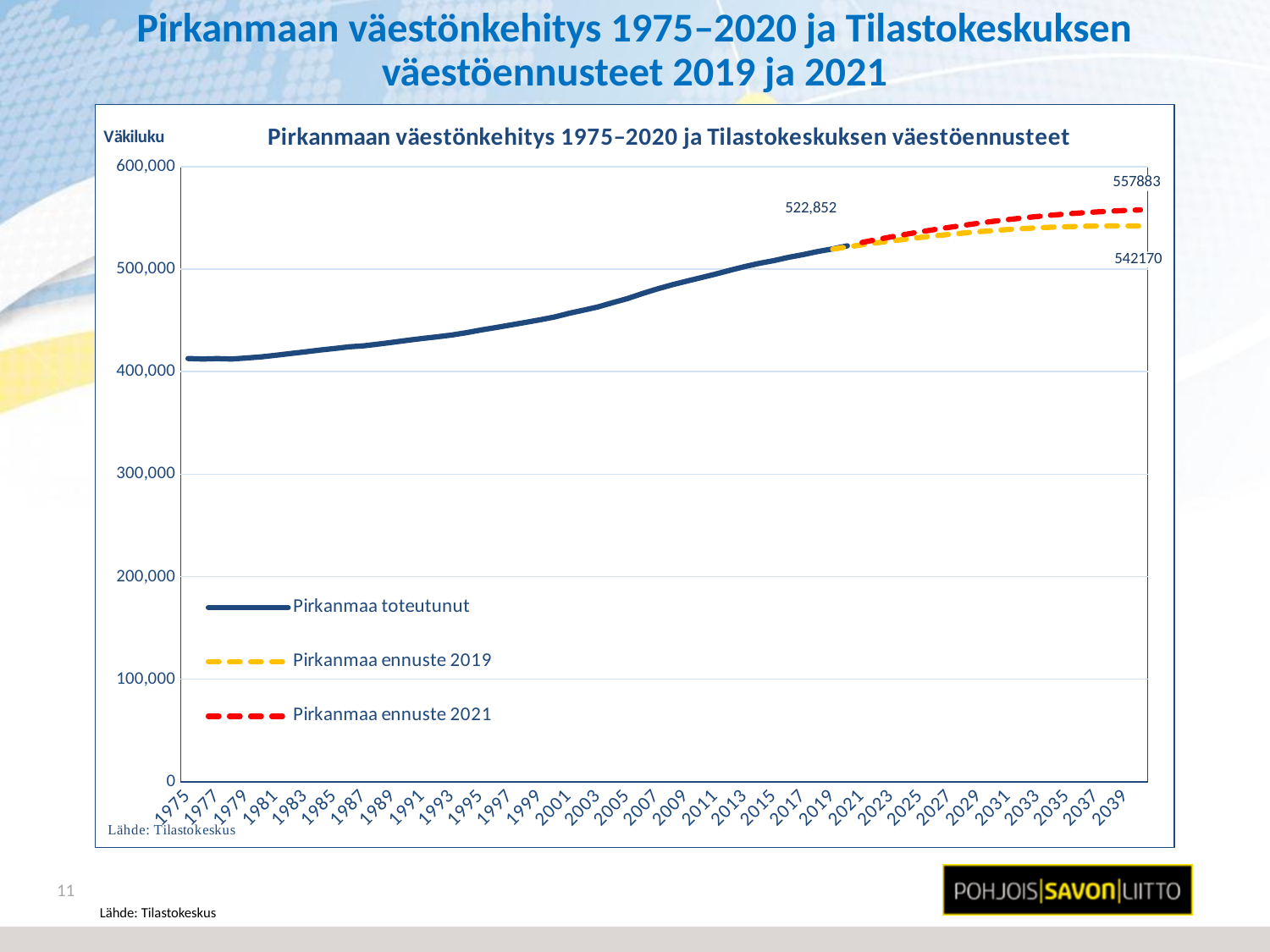
What kind of chart is shown on the slide? line chart Is the population value for 2001 greater or less than 500,000? less Does the Pirkanmaa toteutunut line rise or fall from 1975 to 2020? rise What label is shown on the vertical axis of the chart? Väkiluku What is the final value shown for the Pirkanmaa ennuste 2019 series? 542170 What is the difference between the final values of the 2021 forecast (557883) and the 2019 forecast (542170)? 15713 Which forecast series ends at a higher value, Pirkanmaa ennuste 2019 or Pirkanmaa ennuste 2021? Pirkanmaa ennuste 2021 What is the final value shown for the Pirkanmaa ennuste 2021 series? 557883 How many series does the legend list? 3 Is the population value for 1975 greater or less than 400,000? greater What is the data label shown at the end of the Pirkanmaa toteutunut (actual) line? 522,852 How much higher is the 2021 forecast end value (557883) than the last actual value (522,852)? 35031